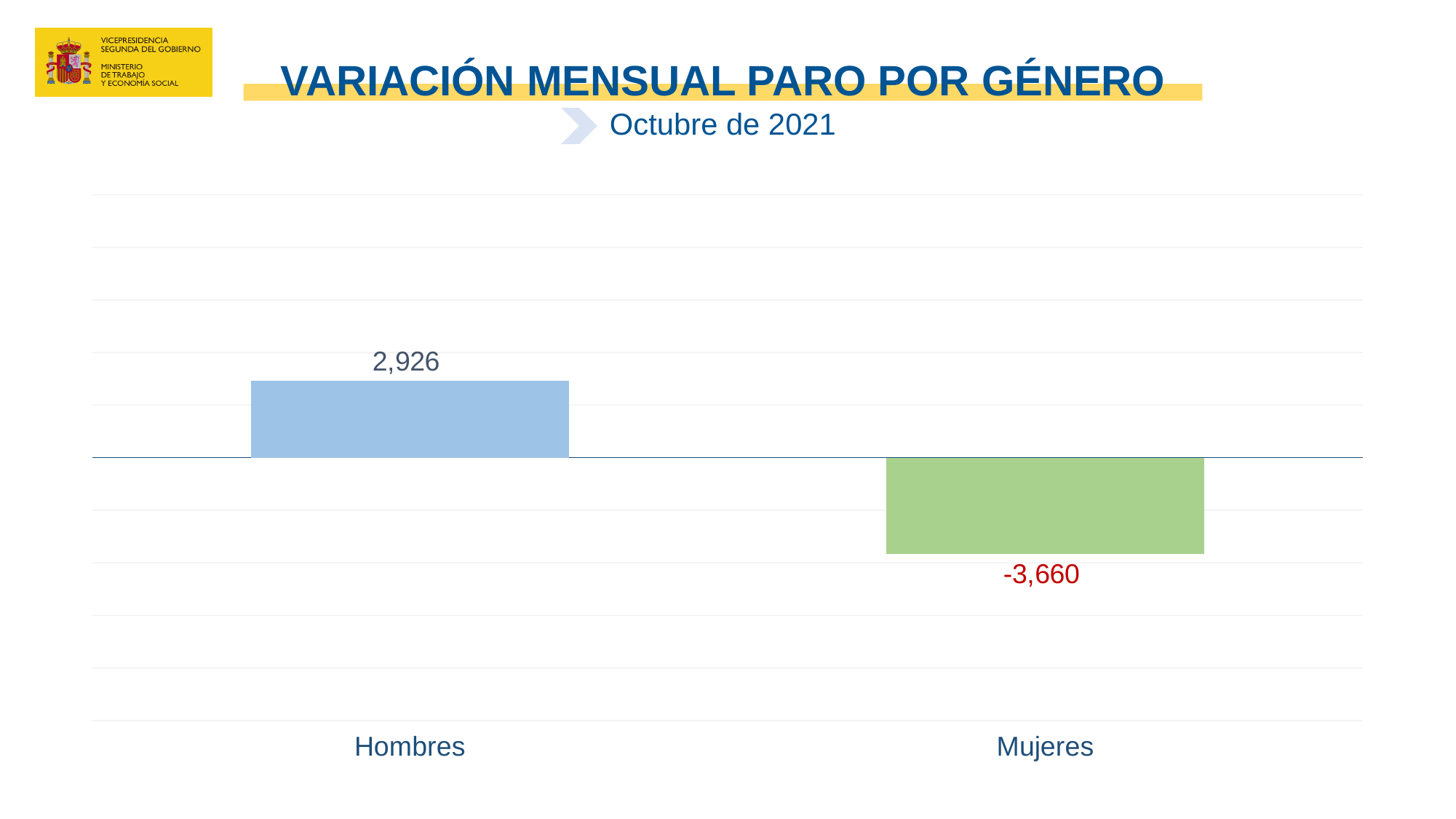
Is the value for Mujeres positive or negative? Negative Which is larger, the value for Hombres or the value for Mujeres? Hombres Which month and year does the chart refer to? Octubre de 2021 What is the value for Mujeres? -3,660 What is the difference between the value for Hombres and the value for Mujeres? 6,586 Which category has the highest value? Hombres What is the title of the chart? VARIACIÓN MENSUAL PARO POR GÉNERO How many categories are shown on the chart? 2 What kind of chart is shown on the slide? Bar chart What is the value for Hombres? 2,926 Which category has the lowest value? Mujeres